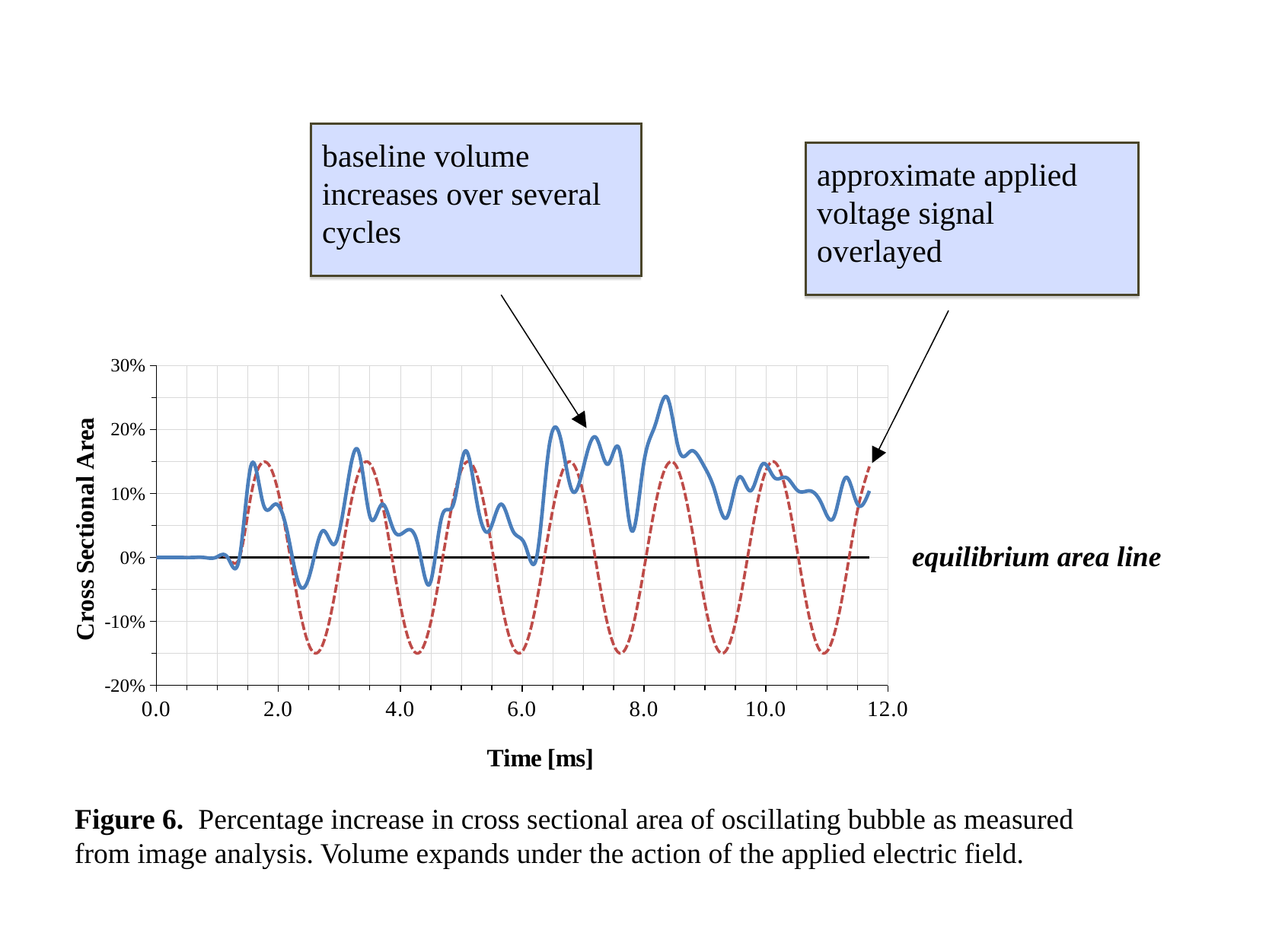
Is the highest value reached by the solid blue line greater or less than 20%? greater What is the label of the horizontal axis of the chart? Time [ms] What is the label of the vertical axis of the chart? Cross Sectional Area Does the baseline of the solid blue line rise or fall over the first several cycles along the time axis? rise What kind of chart is shown on the slide? line chart What is the maximum value shown on the horizontal time axis? 12.0 Is the highest value reached by the solid blue line greater or less than 30%? less Are the peaks of the red dashed line greater or less than 20%? less Which line reaches a higher peak value, the solid blue line or the red dashed line? the solid blue line